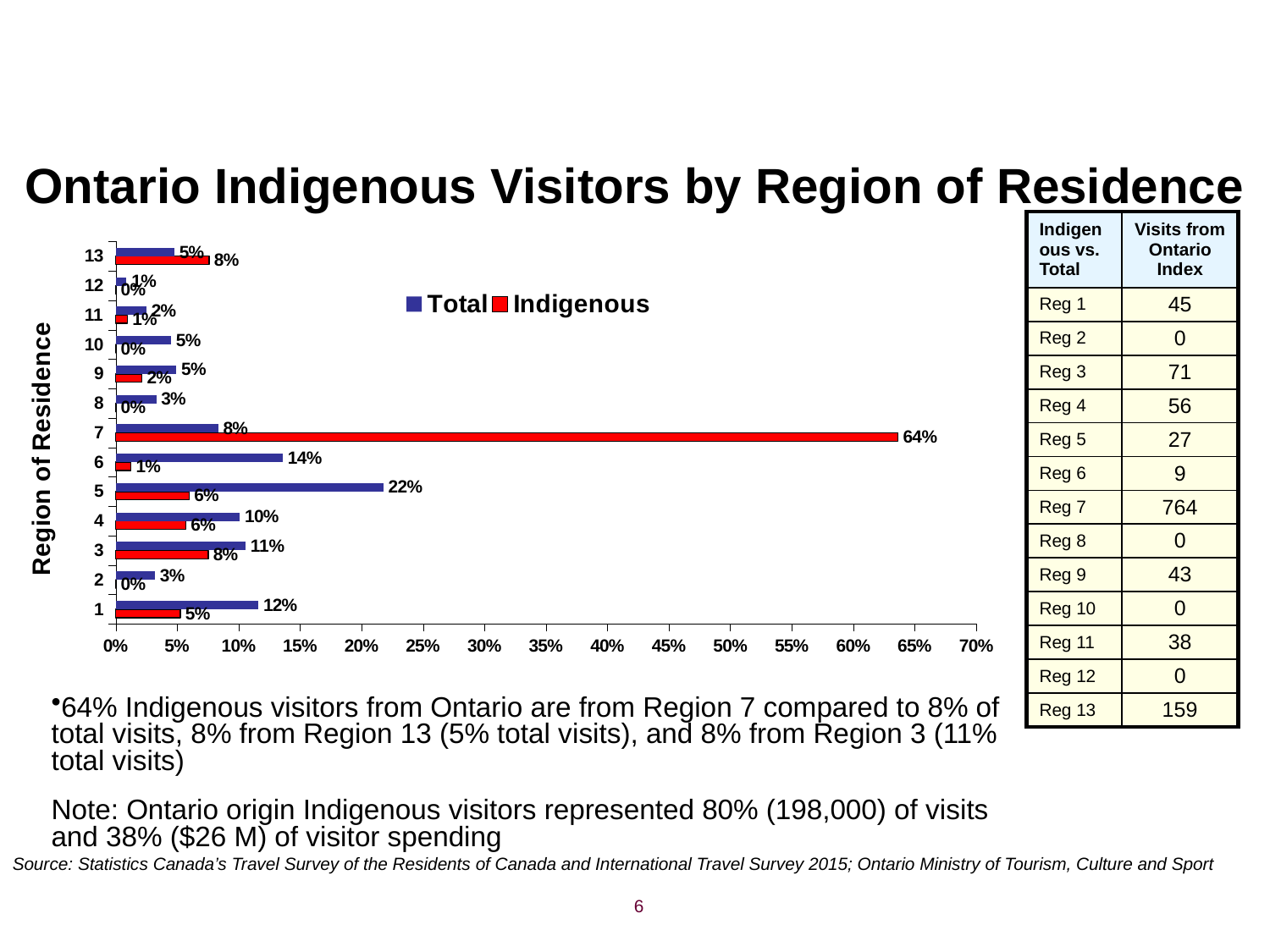
What kind of chart is shown on the slide? Bar chart What is the Indigenous value for Region 7? 64% How many series does the chart legend list? 2 What is the Total value for Region 5? 22% Which region has the highest Indigenous value? Region 7 What is the difference between the Indigenous and Total values for Region 7? 56% What is the Total value for Region 1? 12% Which colour represents the Indigenous series in the chart? Red How many regions are shown on the y axis of the chart? 13 Which region has the highest Total value? Region 5 For Region 3, which is larger, the Total value or the Indigenous value? Total What is the Indigenous value for Region 13? 8%